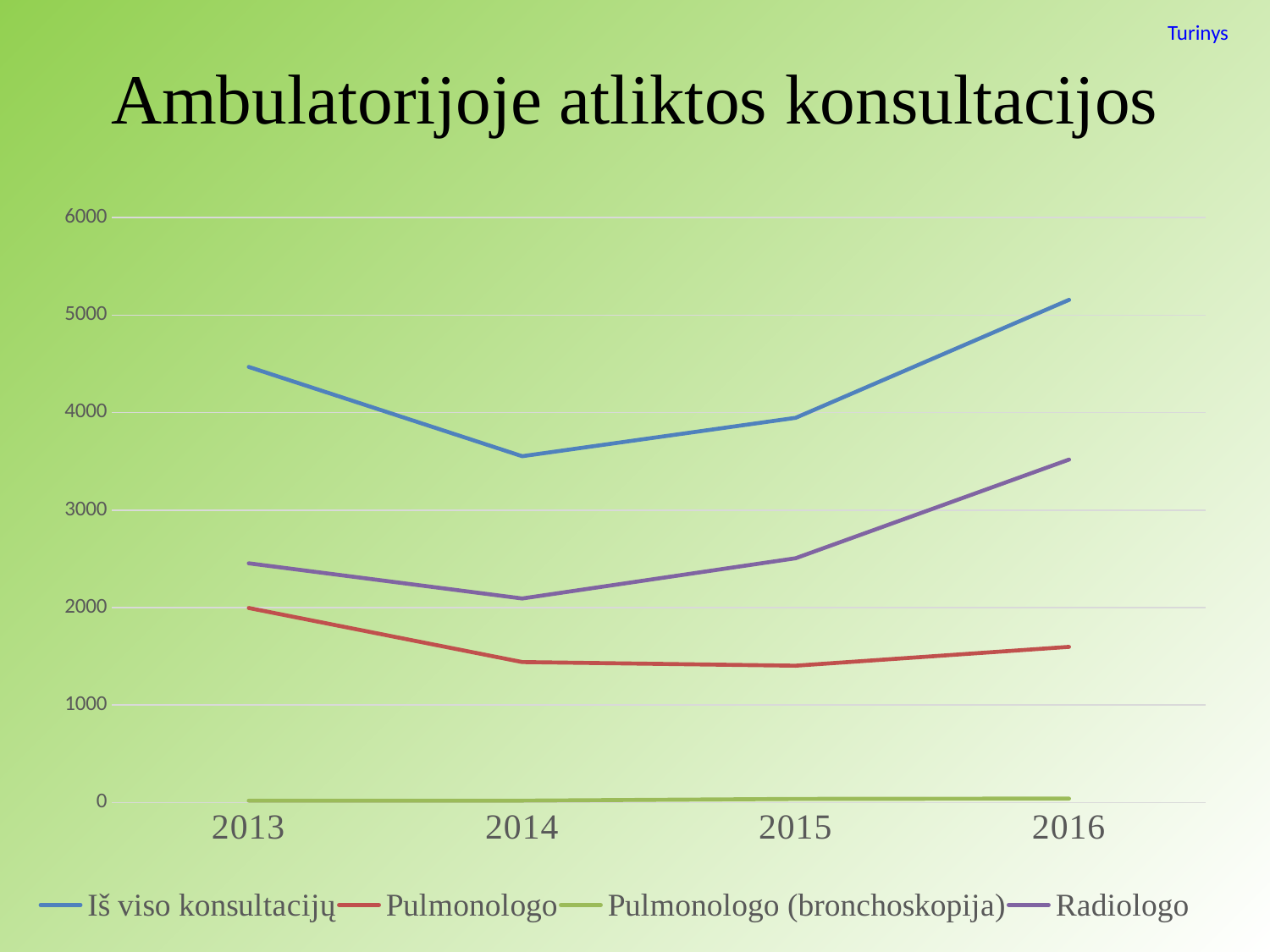
Which series is drawn with the blue line? Iš viso konsultacijų How many years are shown on the x axis? 4 What kind of chart is shown on the slide? line chart In which year is the value for Iš viso konsultacijų highest? 2016 What is the title of the chart? Ambulatorijoje atliktos konsultacijos Does the value for Radiologo rise or fall from 2014 to 2016? rise How many series does the legend list? 4 Is the value for Pulmonologo in 2013 greater or less than 1000? greater Which is larger in 2016, the value for Radiologo or the value for Pulmonologo? Radiologo Is the value for Iš viso konsultacijų in 2016 greater or less than 5000? greater Is the value for Radiologo in 2014 greater or less than 3000? less In which year is the value for Iš viso konsultacijų lowest? 2014